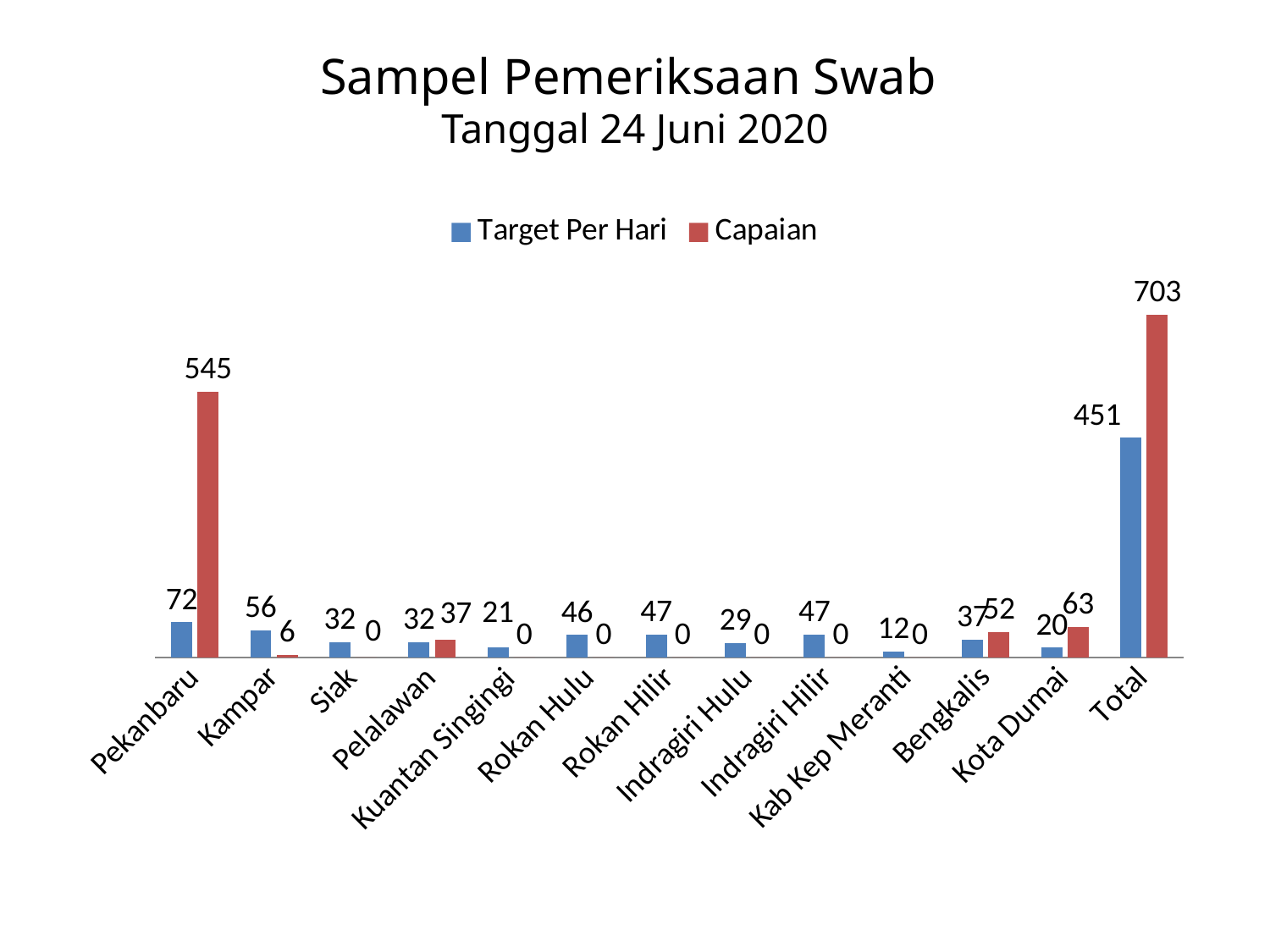
What is the Target Per Hari value for Kab Kep Meranti? 12 How many categories are shown on the x axis? 13 What type of chart is shown on the slide? Bar chart Excluding the Total category, which category has the highest Capaian value? Pekanbaru What is the Target Per Hari value for Kampar? 56 What is the Capaian value for Pekanbaru? 545 What is the difference between the Capaian and Target Per Hari values for Bengkalis? 15 How many series does the legend list? 2 What is the Capaian value for Kota Dumai? 63 What is the difference between the Capaian and Target Per Hari values for Total? 252 Which is larger for Pelalawan, Target Per Hari or Capaian? Capaian Which category has the lowest Target Per Hari value? Kab Kep Meranti